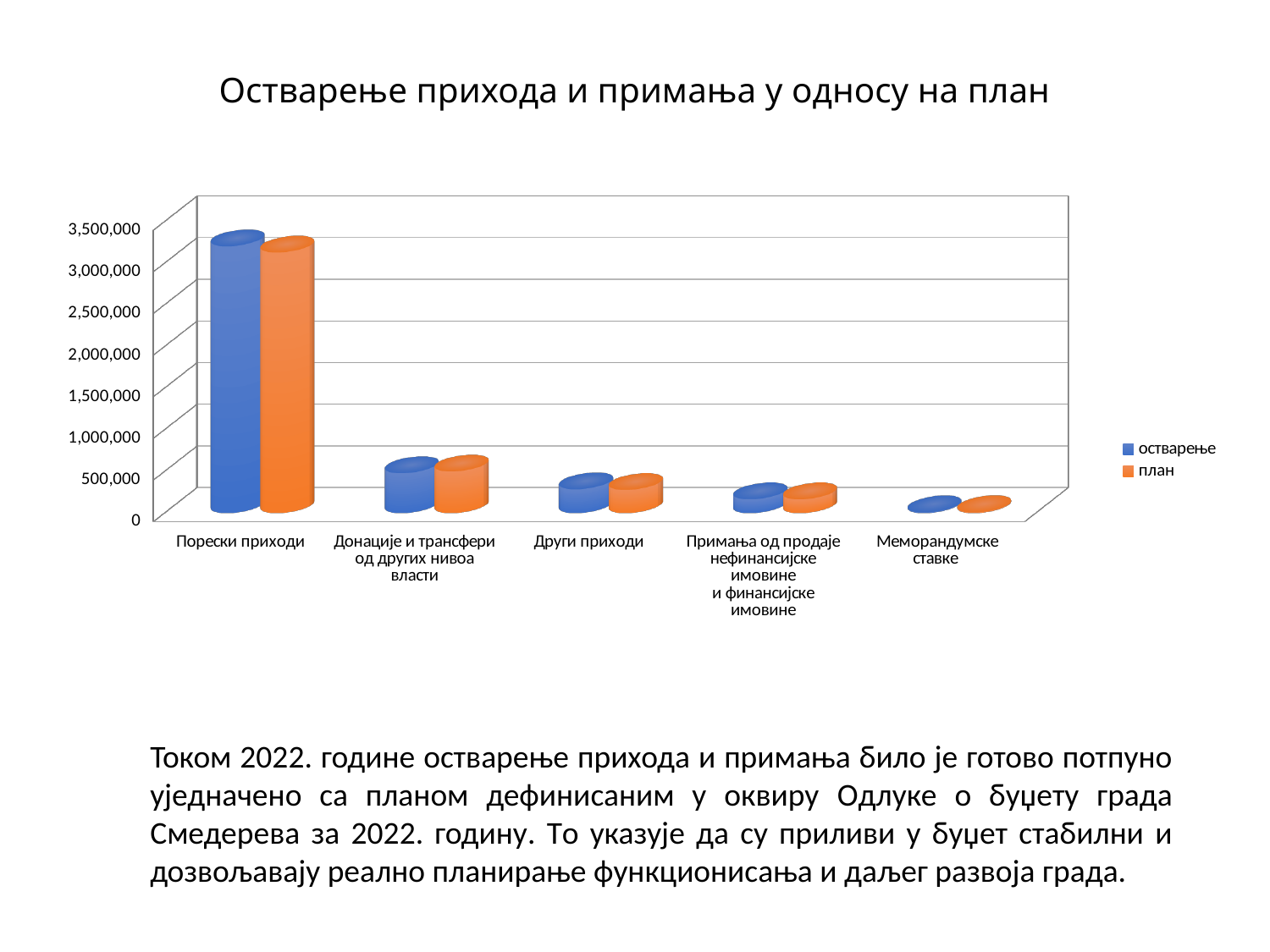
What is the title of the chart? Остварење прихода и примања у односу на план How many categories are shown on the x axis? 5 Which category has the highest value for остварење? Порески приходи Which is larger: the план value for Порески приходи or the план value for Донације и трансфери од других нивоа власти? Порески приходи Which colour represents the план series in the legend? orange Is the остварење value for Порески приходи greater or less than 3,000,000? greater How many series does the legend list? 2 Which category has the lowest value for план? Меморандумске ставке Is the остварење value for Други приходи greater or less than 1,000,000? less Do the остварење values rise or fall from left to right along the x axis? fall What kind of chart is shown on the slide? bar chart Is the план value for Меморандумске ставке greater or less than 500,000? less